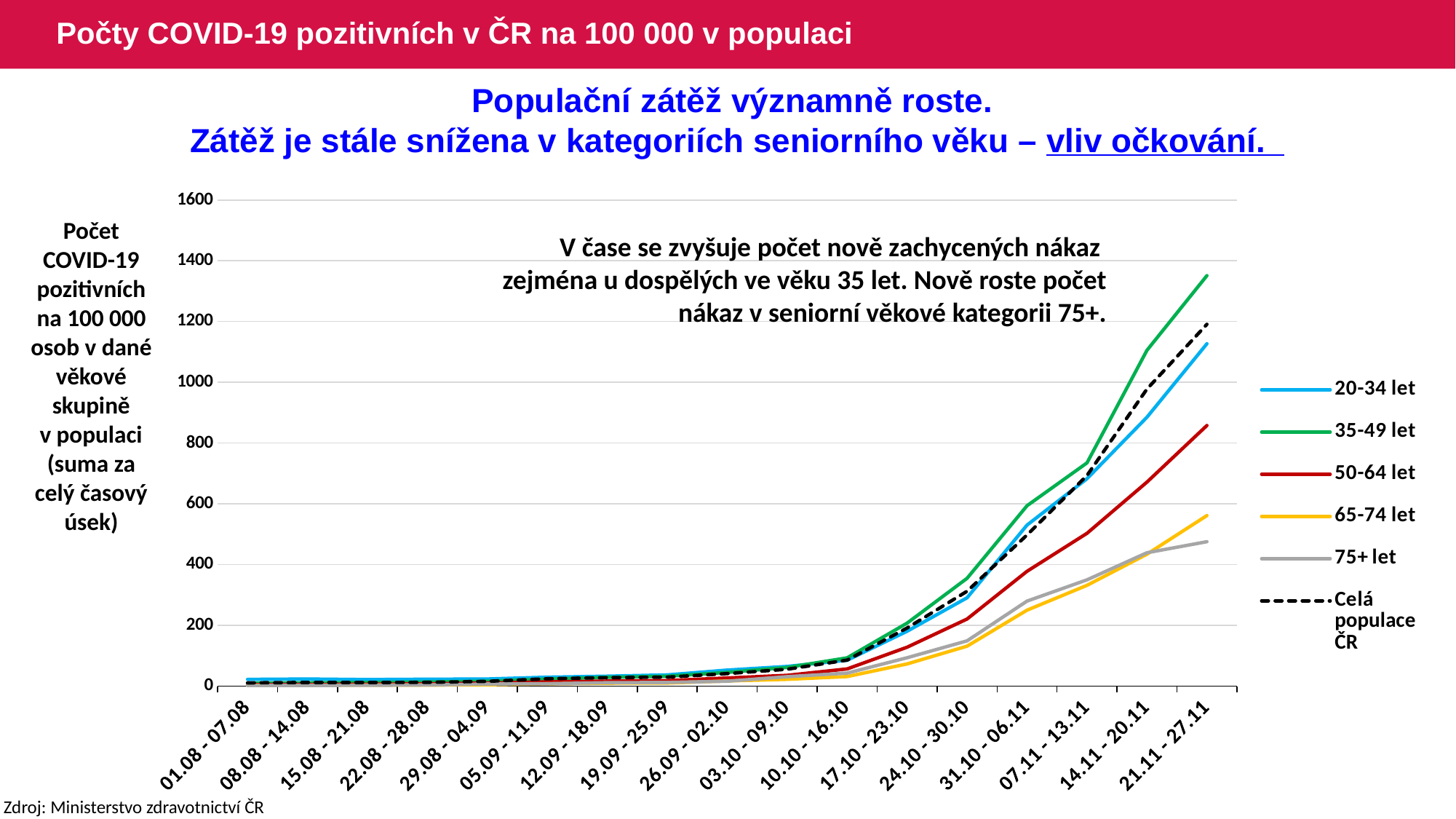
How many series does the chart legend list? 6 Is the value for Celá populace ČR in the period 21.11 - 27.11 greater or less than 1000? greater Which age group has the highest value in the period 21.11 - 27.11? 35-49 let Which age group has the lowest value in the period 21.11 - 27.11? 75+ let How many weekly periods are shown on the x axis of the chart? 17 What kind of chart is shown on the slide? line chart Is the value for 65-74 let in the period 21.11 - 27.11 greater or less than 800? less Which series in the legend is drawn with a dashed line? Celá populace ČR In the period 21.11 - 27.11, which is larger: the value for 20-34 let or the value for 50-64 let? 20-34 let Do the values for 35-49 let rise or fall over the periods shown on the x axis? rise Is the value for 75+ let in the period 21.11 - 27.11 greater or less than 600? less